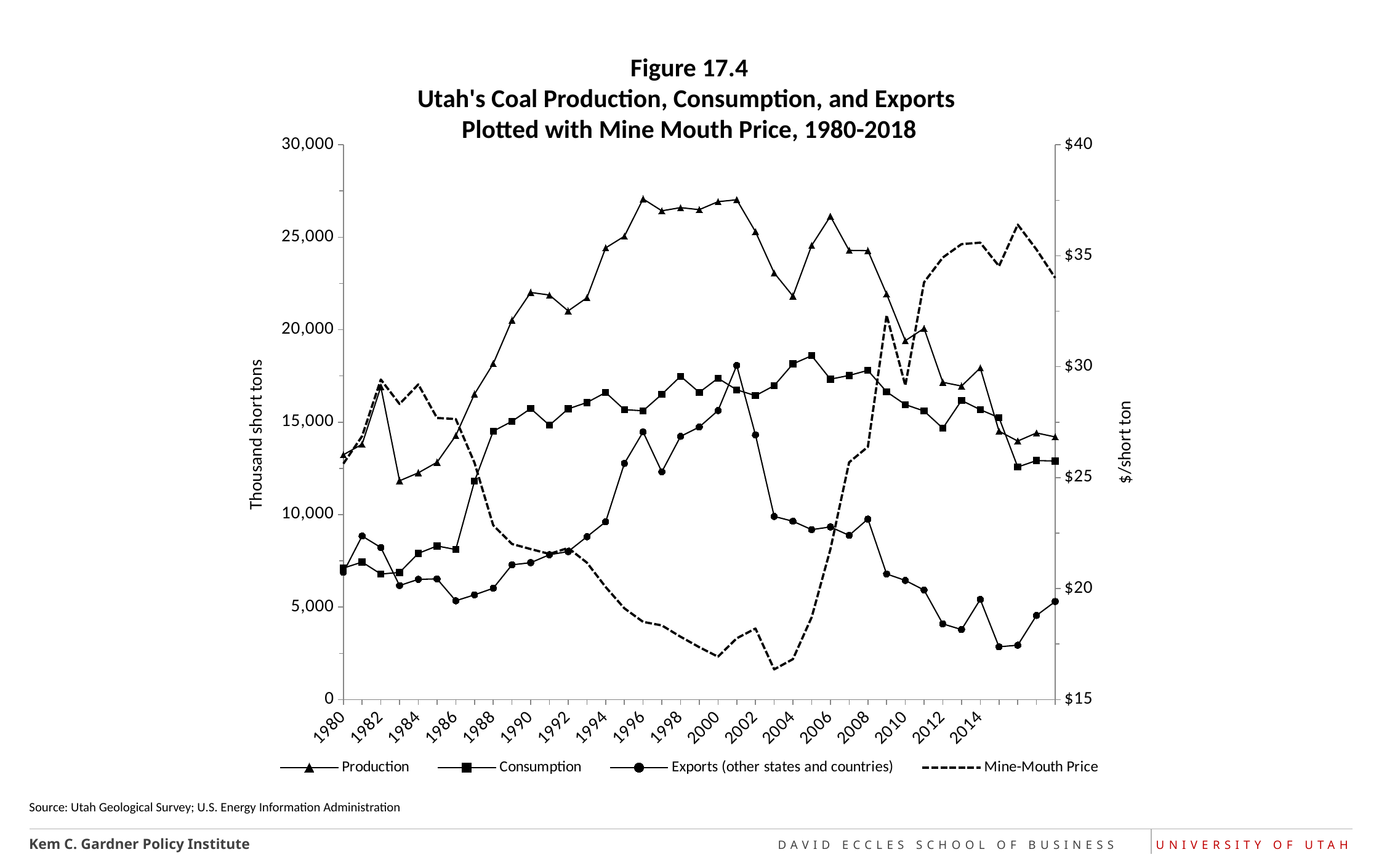
Which series is drawn with a dashed line? Mine-Mouth Price What is the label of the right-hand vertical axis? $/short ton Is the Mine-Mouth Price in 2003 greater or less than $20? less What kind of chart is shown on the slide? Line chart Is the value for Production in 1996 greater or less than 25,000? greater How many series does the legend list? 4 Is the value for Consumption in 2018 greater or less than 15,000? less Does the Production series rise or fall between 2008 and 2018? Fall In 2010, which is larger: Consumption or Exports (other states and countries)? Consumption